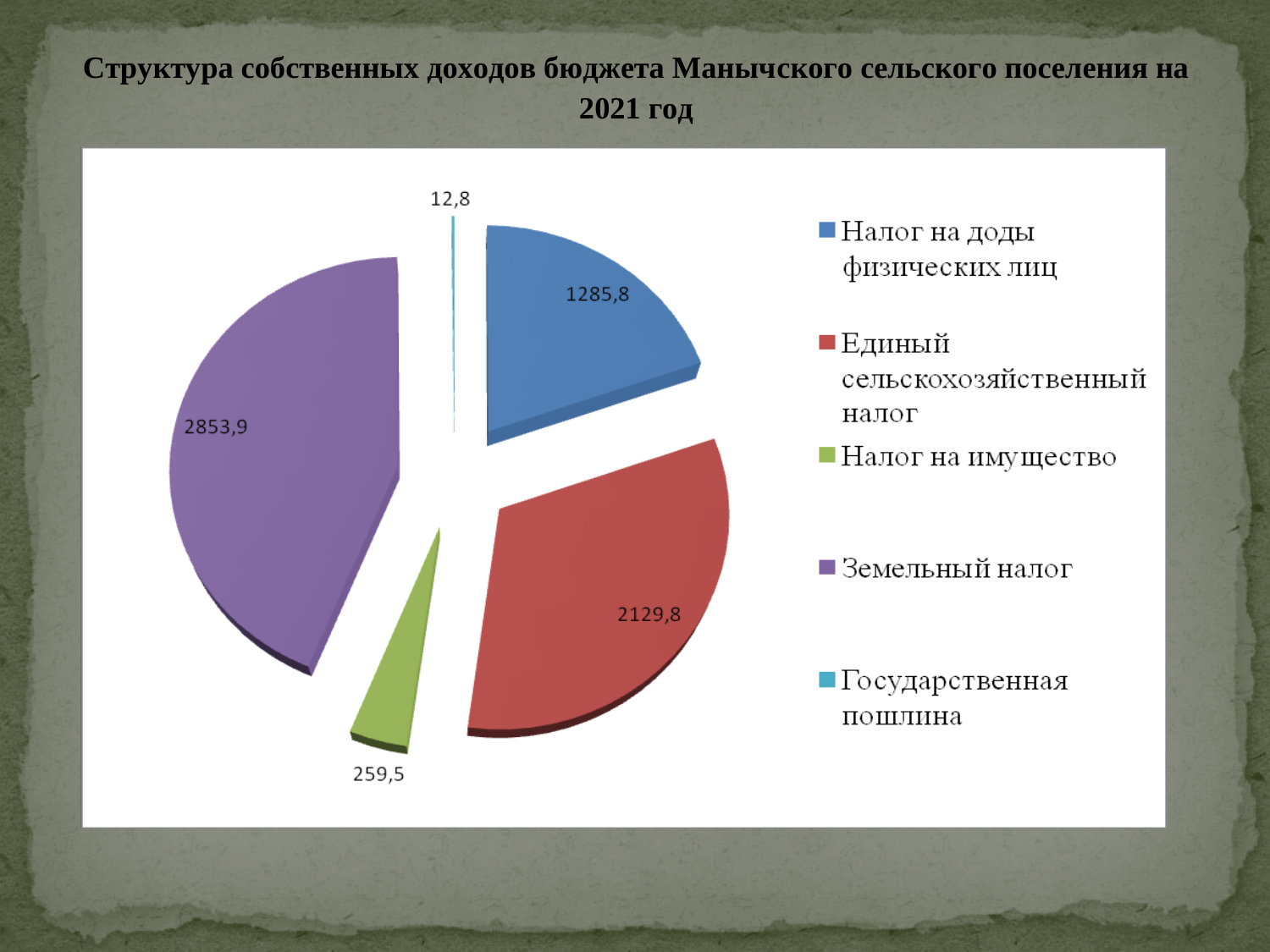
What is the difference between the values for Земельный налог and Единый сельскохозяйственный налог? 724,1 How many slices does the pie chart have? 5 What is the value for Единый сельскохозяйственный налог? 2129,8 What is the value for Государственная пошлина? 12,8 What type of chart is shown on the slide? Pie chart Which is larger: the value for Налог на доды физических лиц or the value for Налог на имущество? Налог на доды физических лиц Which category has the largest slice of the pie? Земельный налог What colour is the slice for Единый сельскохозяйственный налог? Red Which category has the smallest slice of the pie? Государственная пошлина How many entries does the legend list? 5 What is the value for Налог на имущество? 259,5 What is the value for Земельный налог? 2853,9